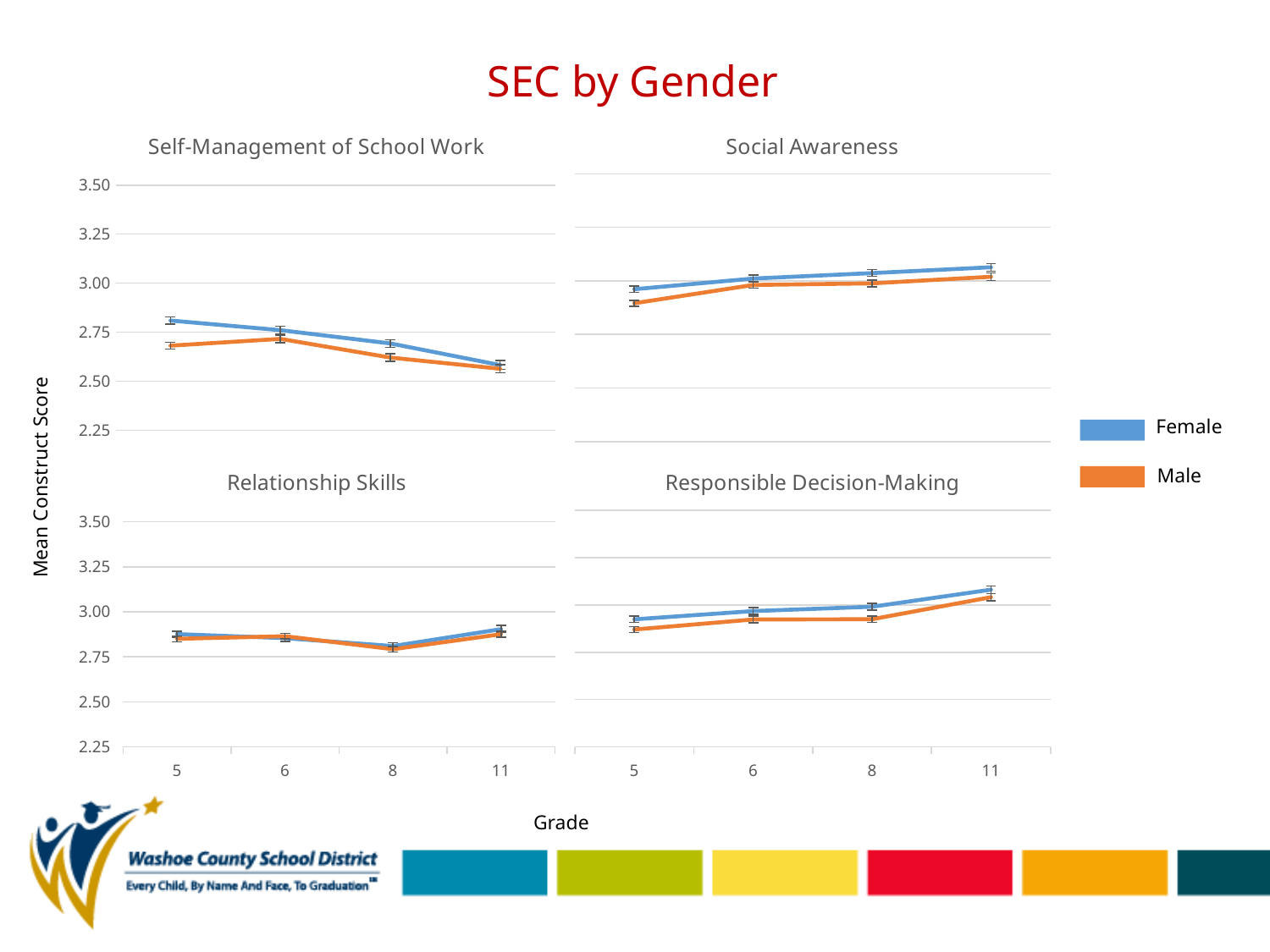
In the "Social Awareness" chart, is the Male value at grade 5 greater or less than 3.00? less What is the label on the shared y axis of the charts? Mean Construct Score How many series does the legend list? 2 In the "Responsible Decision-Making" chart, at which grade is the Female value highest? 11 In the "Social Awareness" chart, do the Male values rise or fall from grade 5 to grade 11? rise In the "Self-Management of School Work" chart, do the Female values rise or fall from grade 5 to grade 11? fall How many grade levels are plotted on the x axis of the "Social Awareness" chart? 4 In the "Self-Management of School Work" chart, is the Female value at grade 5 greater or less than 2.75? greater In the "Responsible Decision-Making" chart, is the Female value at grade 11 greater or less than 3.00? greater What kind of chart is used in the "Self-Management of School Work" panel? line chart In the "Self-Management of School Work" chart, which is larger at grade 5, the Female value or the Male value? Female In the "Relationship Skills" chart, at which grade is the Female value lowest? 8